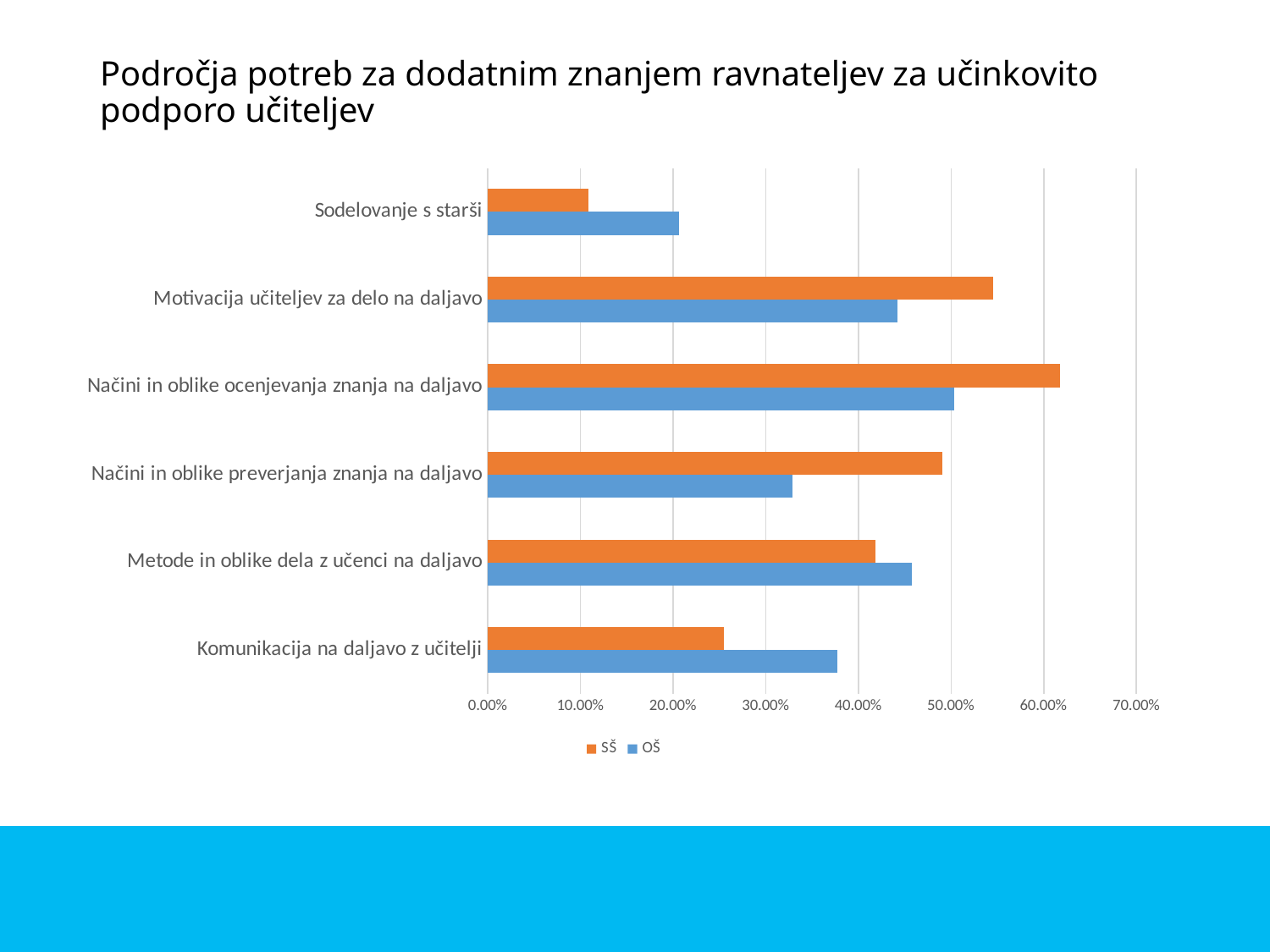
Which category has the lowest value for the SŠ series? Sodelovanje s starši Which category has the highest value for the SŠ series? Načini in oblike ocenjevanja znanja na daljavo For Motivacija učiteljev za delo na daljavo, which series has the larger value, SŠ or OŠ? SŠ Is the SŠ value for Načini in oblike ocenjevanja znanja na daljavo greater or less than 50.00%? greater For Komunikacija na daljavo z učitelji, which series has the larger value, SŠ or OŠ? OŠ Which category has the highest value for the OŠ series? Načini in oblike ocenjevanja znanja na daljavo Which colour represents the SŠ series in the legend? orange What kind of chart is shown on the slide? bar chart Is the OŠ value for Sodelovanje s starši greater or less than 30.00%? less How many categories are shown on the chart? 6 Which category has the lowest value for the OŠ series? Sodelovanje s starši How many series does the legend list? 2